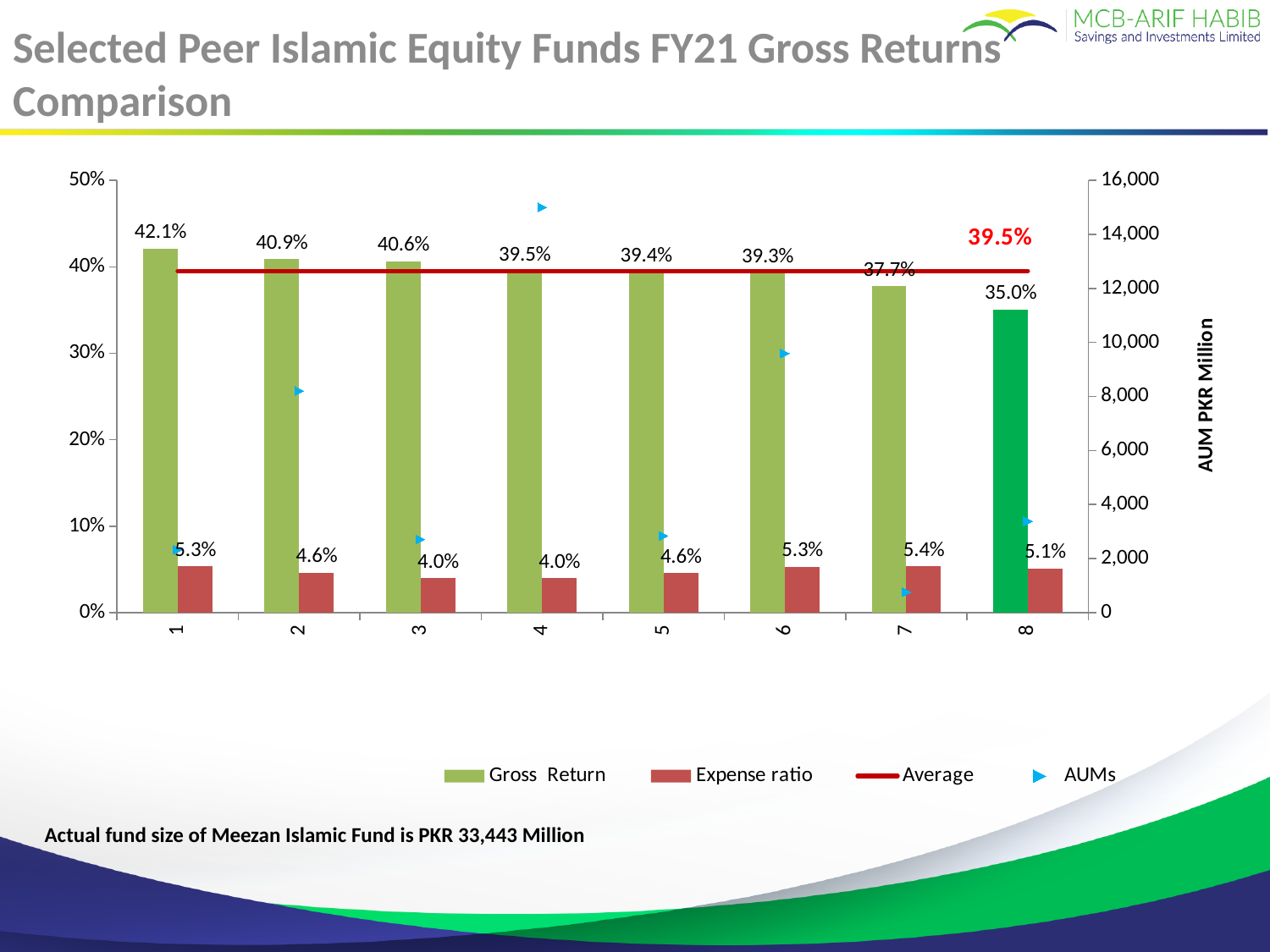
Do the Gross Return values rise or fall from fund 1 to fund 8? fall How many series does the legend list? 4 What is the difference between the Gross Return of fund 1 and fund 8? 7.1 percentage points What is the Gross Return for fund 1? 42.1% What value is shown for the Average line? 39.5% What is the Expense ratio for fund 7? 5.4% How many funds are shown on the x axis? 8 Which has the larger Expense ratio, fund 2 or fund 6? Fund 6 Is the AUM value for fund 4 greater or less than 14,000? greater Which fund has the highest Gross Return? 1 Which fund has the lowest Gross Return? 8 Is the AUM value for fund 7 greater or less than 2,000? less